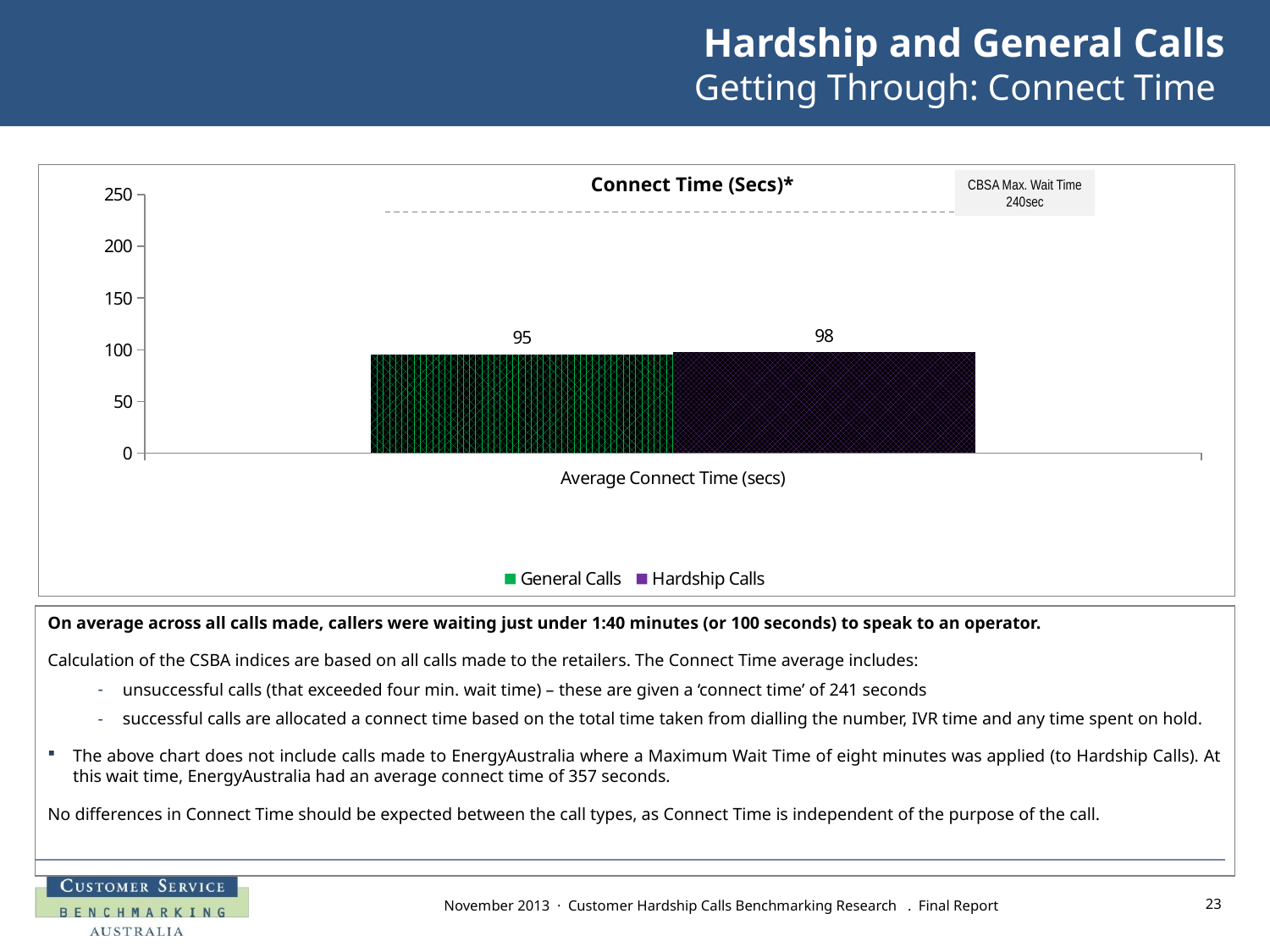
What is the average connect time in seconds for Hardship Calls? 98 What is the label on the x axis category of the chart? Average Connect Time (secs) What is the average connect time in seconds for General Calls? 95 What CBSA maximum wait time is indicated by the dashed line on the chart? 240sec What kind of chart is shown on the slide? bar chart What is the title of the chart? Connect Time (Secs)* Which series has the higher average connect time, General Calls or Hardship Calls? Hardship Calls Is the average connect time for General Calls greater or less than 100? less How many series does the legend list? 2 Is the average connect time for Hardship Calls greater or less than 50? greater What is the difference in average connect time between Hardship Calls and General Calls? 3